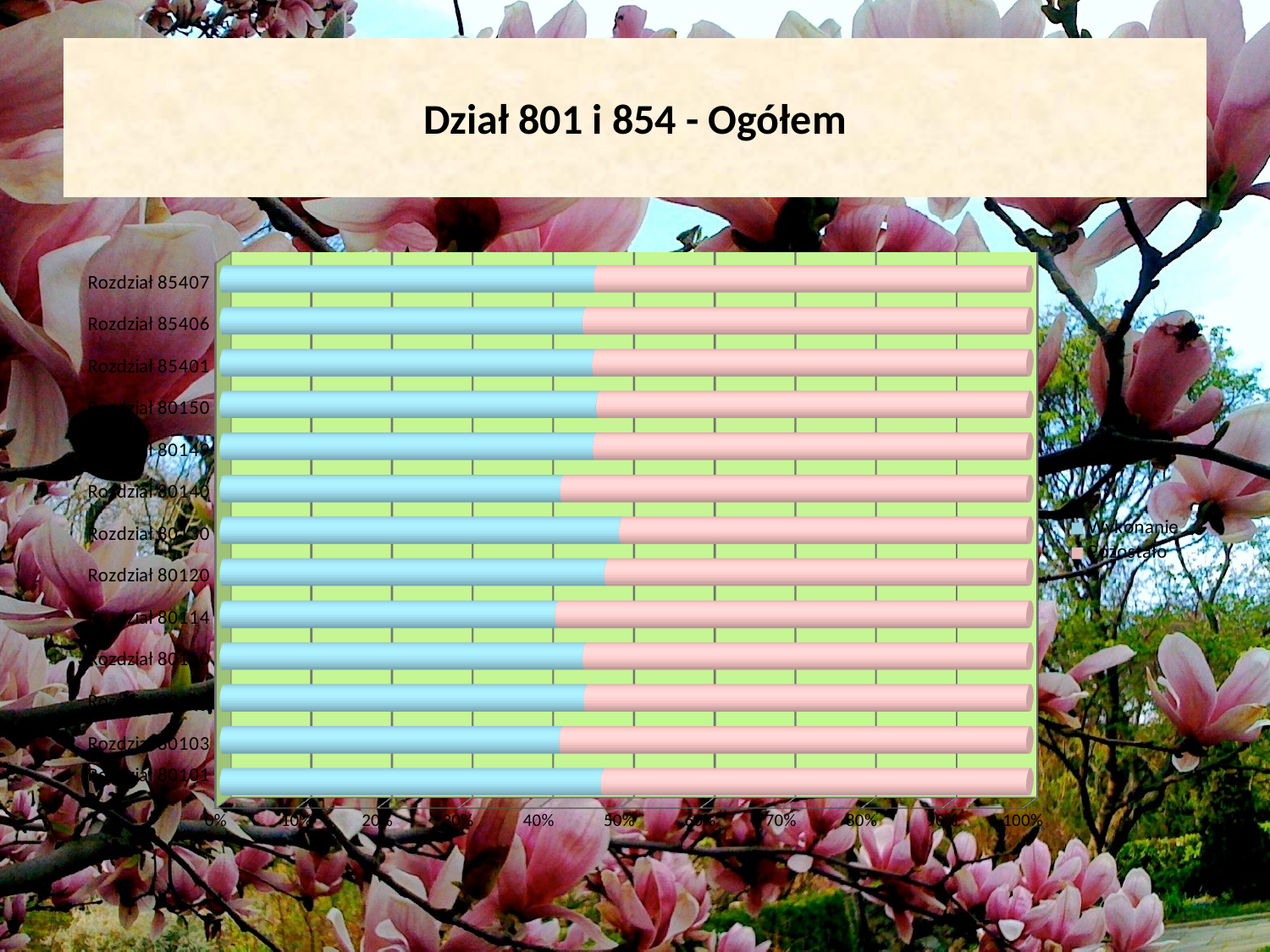
What are the two series named in the legend? Wykonanie and Pozostało Is the Wykonanie value for Rozdział 85407 greater or less than 50%? less Is the Wykonanie value for Rozdział 85407 greater or less than 40%? greater What does each stacked bar total on the percentage axis? 100% What is the title of the slide? Dział 801 i 854 - Ogółem Is the Pozostało value for Rozdział 80140 greater or less than 50%? greater How many series does the legend list? 2 How many categories (bars) are plotted in the chart? 13 What kind of chart is shown on the slide? bar chart Which has the larger Wykonanie share, Rozdział 80120 or Rozdział 80140? Rozdział 80120